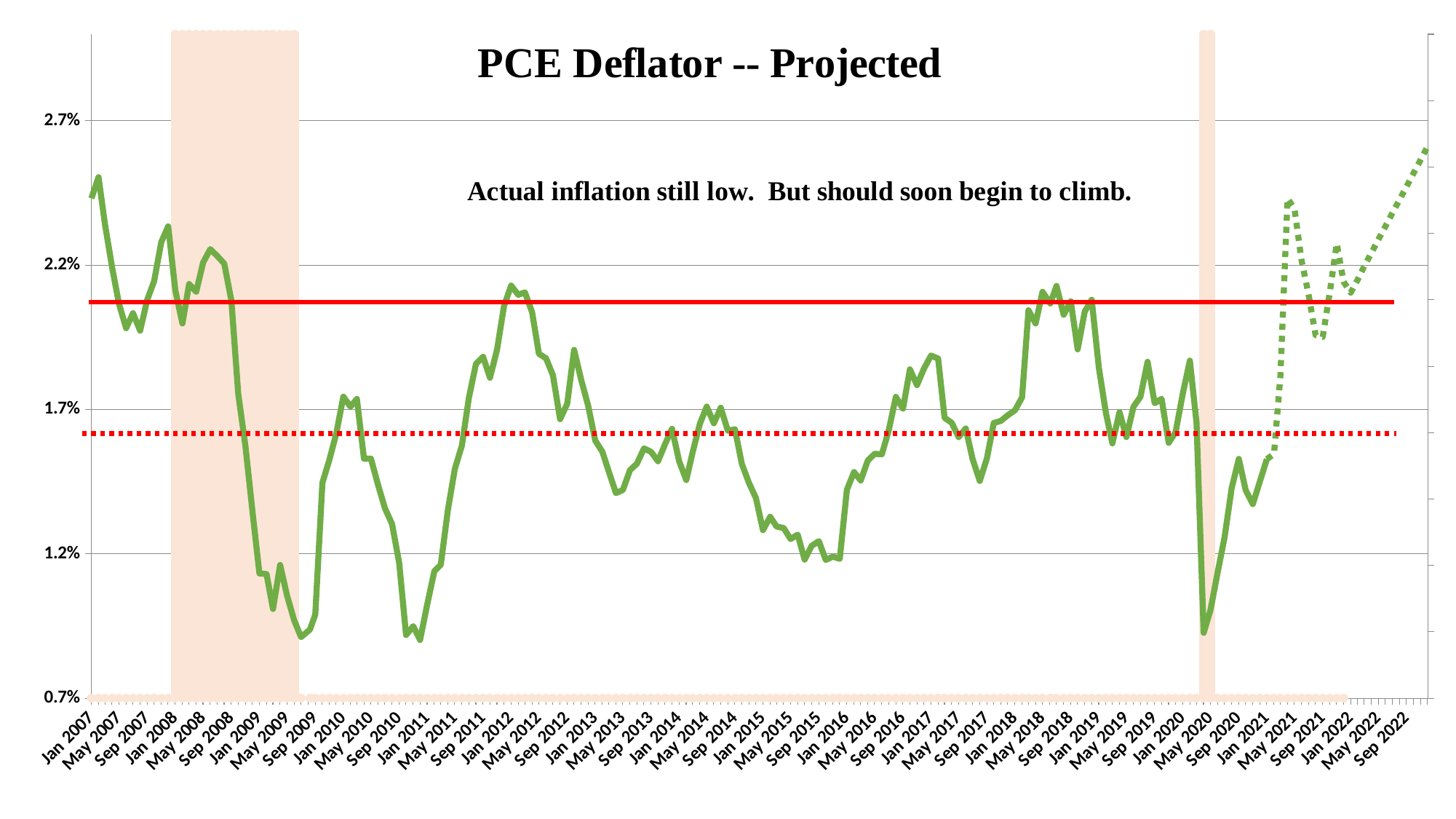
Is the value for May 2009 greater or less than 1.2%? less Does the projected dashed line rise or fall overall between Jan 2021 and Sep 2022? rise What annotation text is written inside the chart area? Actual inflation still low. But should soon begin to climb. Is the value for Jan 2012 greater or less than 1.7%? greater Is the value for Jan 2007 greater or less than 2.2%? greater What kind of chart is shown on the slide? line chart What is the title of the chart? PCE Deflator -- Projected Is the value for Jan 2007 larger or smaller than the value for May 2009? larger Does the line rise or fall between Jan 2008 and May 2009? fall